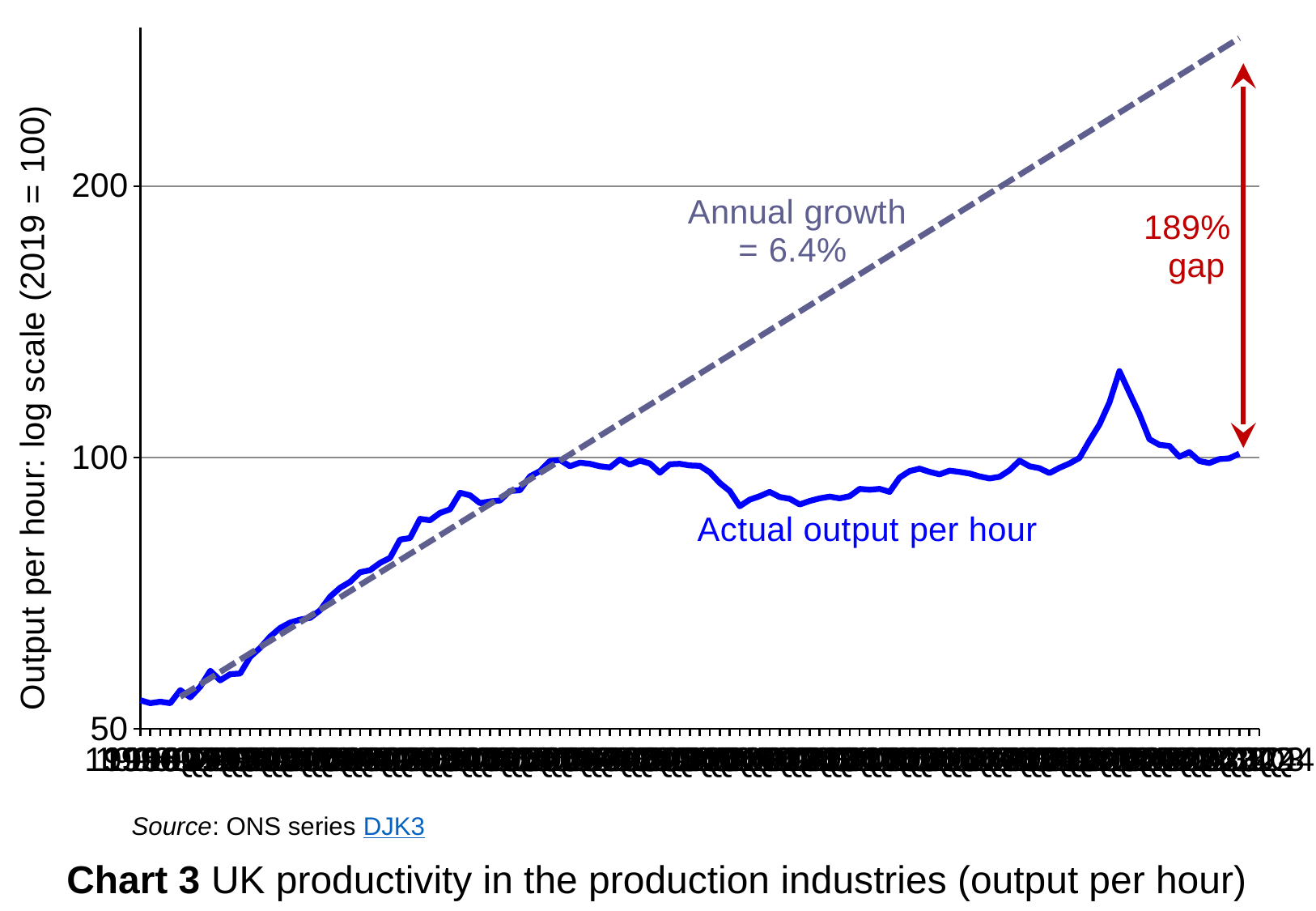
How many lines are plotted on the chart? 2 What is the size of the gap between the trend line and actual output per hour at the end of the series, as labelled on the chart? 189% At the right-hand end of the chart, is the actual output per hour line greater or less than 200? less What annual growth rate is shown for the dashed trend line? 6.4% Does the dashed trend line rise or fall from left to right? rises What kind of chart is shown on the slide? line chart Is the highest peak of the actual output per hour line greater or less than 100? greater What is the title of the chart? Chart 3 UK productivity in the production industries (output per hour) At the left-hand start of the chart, is the actual output per hour line greater or less than 100? less What is the label on the vertical axis? Output per hour: log scale (2019 = 100) At the right-hand end of the chart, which is higher: the dashed trend line or the actual output per hour line? the dashed trend line